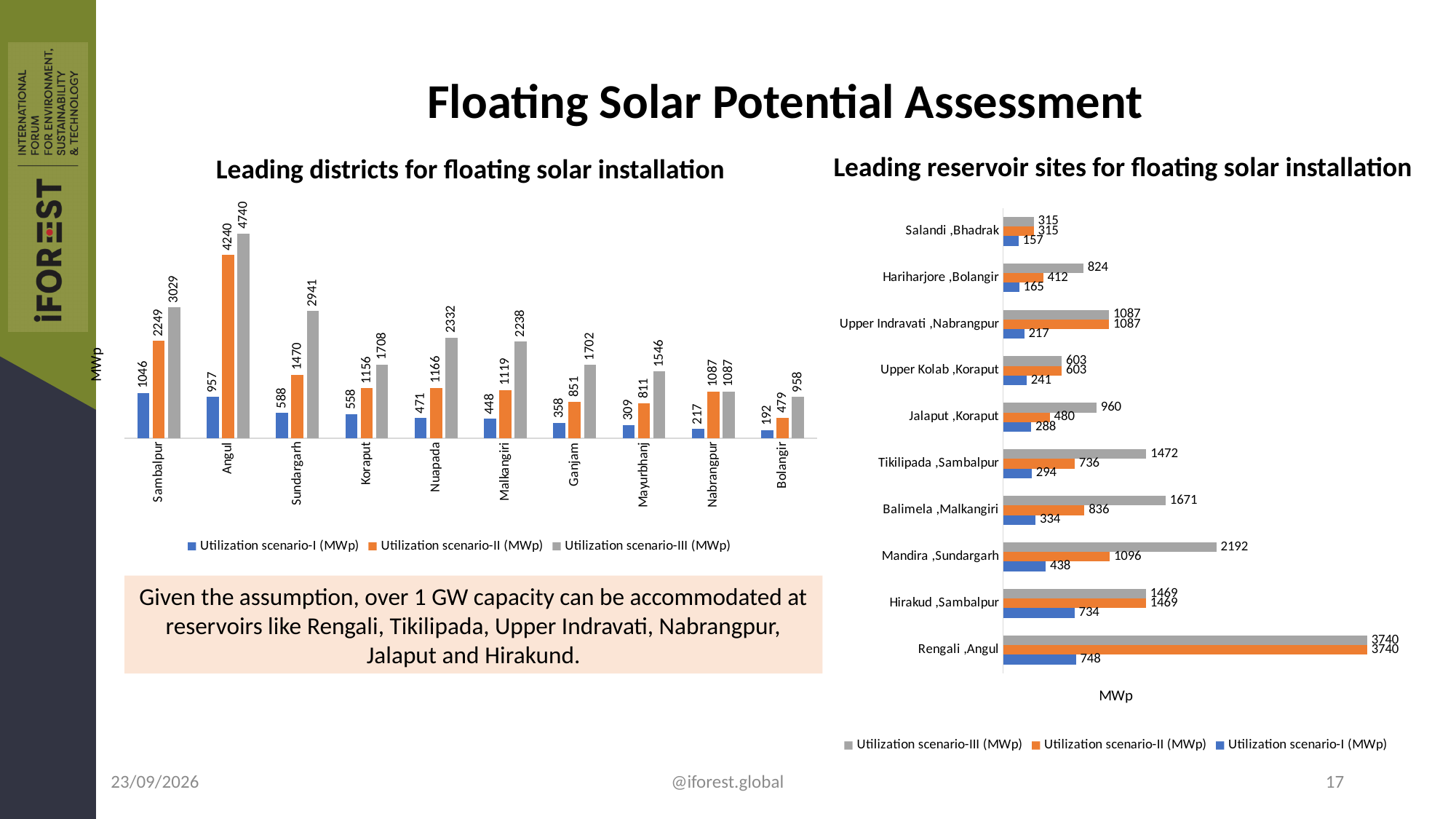
In the 'Leading districts for floating solar installation' chart, what is the Utilization scenario-I (MWp) value for Sambalpur? 1046 In the 'Leading districts for floating solar installation' chart, which district has the highest Utilization scenario-II (MWp) value? Angul In the 'Leading districts for floating solar installation' chart, what is the difference between the Utilization scenario-III and scenario-II values for Sundargarh? 1471 What kind of chart is the 'Leading reservoir sites for floating solar installation' chart? Bar chart In the 'Leading reservoir sites for floating solar installation' chart, what is the Utilization scenario-III (MWp) value for Mandira, Sundargarh? 2192 How many series does the legend of the 'Leading districts for floating solar installation' chart list? 3 In the 'Leading reservoir sites for floating solar installation' chart, what is the difference between the Utilization scenario-II and scenario-I values for Balimela, Malkangiri? 502 In the 'Leading districts for floating solar installation' chart, which district has the lowest Utilization scenario-I (MWp) value? Bolangir In the 'Leading reservoir sites for floating solar installation' chart, which reservoir site has the highest Utilization scenario-I (MWp) value? Rengali, Angul In the 'Leading reservoir sites for floating solar installation' chart, which is larger: the Utilization scenario-III value for Tikilipada, Sambalpur or for Hirakud, Sambalpur? Tikilipada, Sambalpur How many districts are shown in the 'Leading districts for floating solar installation' chart? 10 In the 'Leading districts for floating solar installation' chart, what is the Utilization scenario-III (MWp) value for Angul? 4740